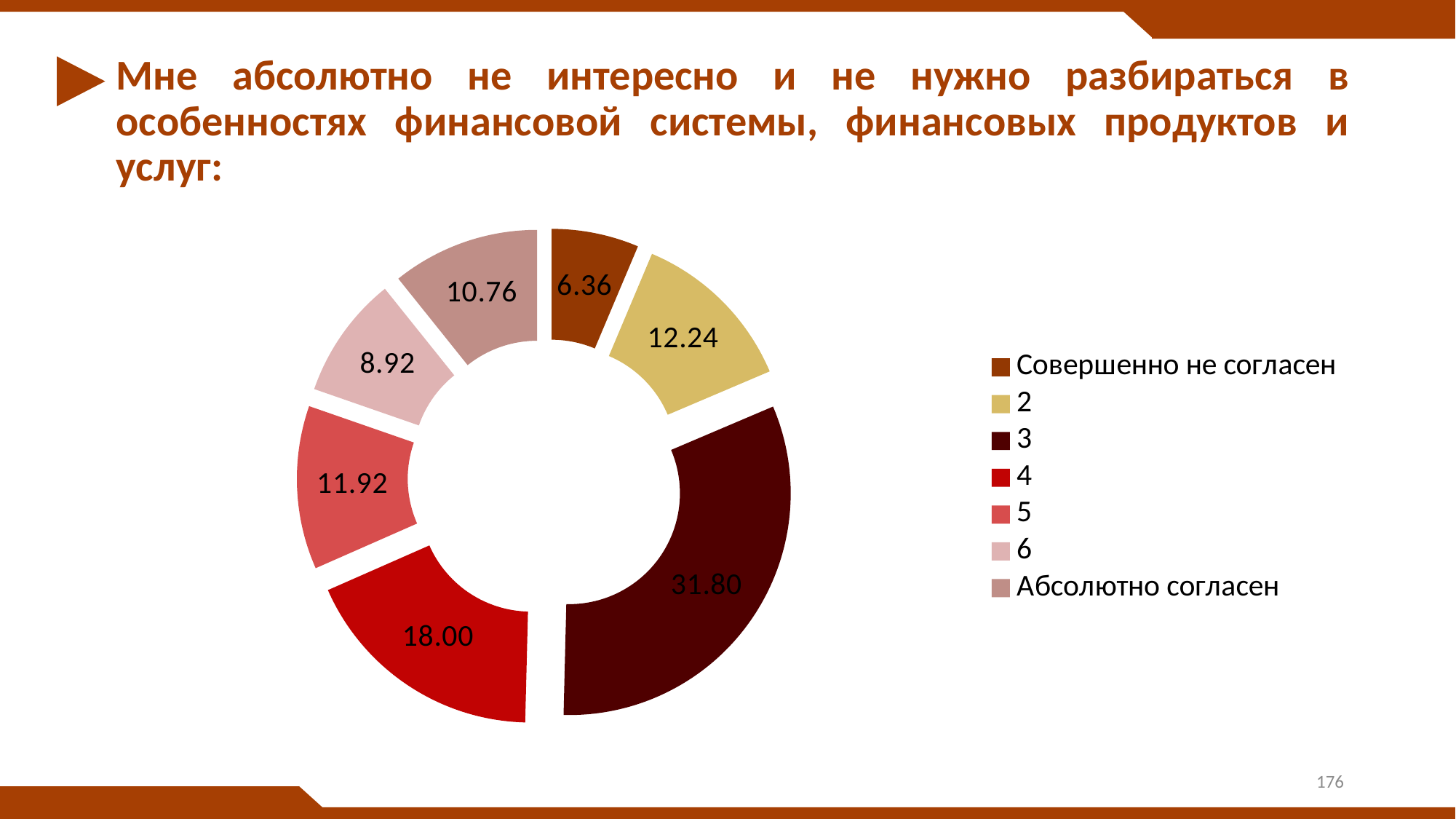
What is the difference between the values for "3" and "4"? 13.80 What value is shown for the slice labelled "3"? 31.80 What value is shown for the slice labelled "5"? 11.92 Which category has the smallest slice? Совершенно не согласен Which category has the largest slice? 3 What value is shown for the "Совершенно не согласен" slice? 6.36 Which legend entry is shown in the darkest colour? 3 What kind of chart is shown on the slide? doughnut chart How many slices does the chart have? 7 Which is larger, the value for "4" or the value for "2"? 4 What value is shown for the "Абсолютно согласен" slice? 10.76 What is the difference between the values for "2" and "Совершенно не согласен"? 5.88